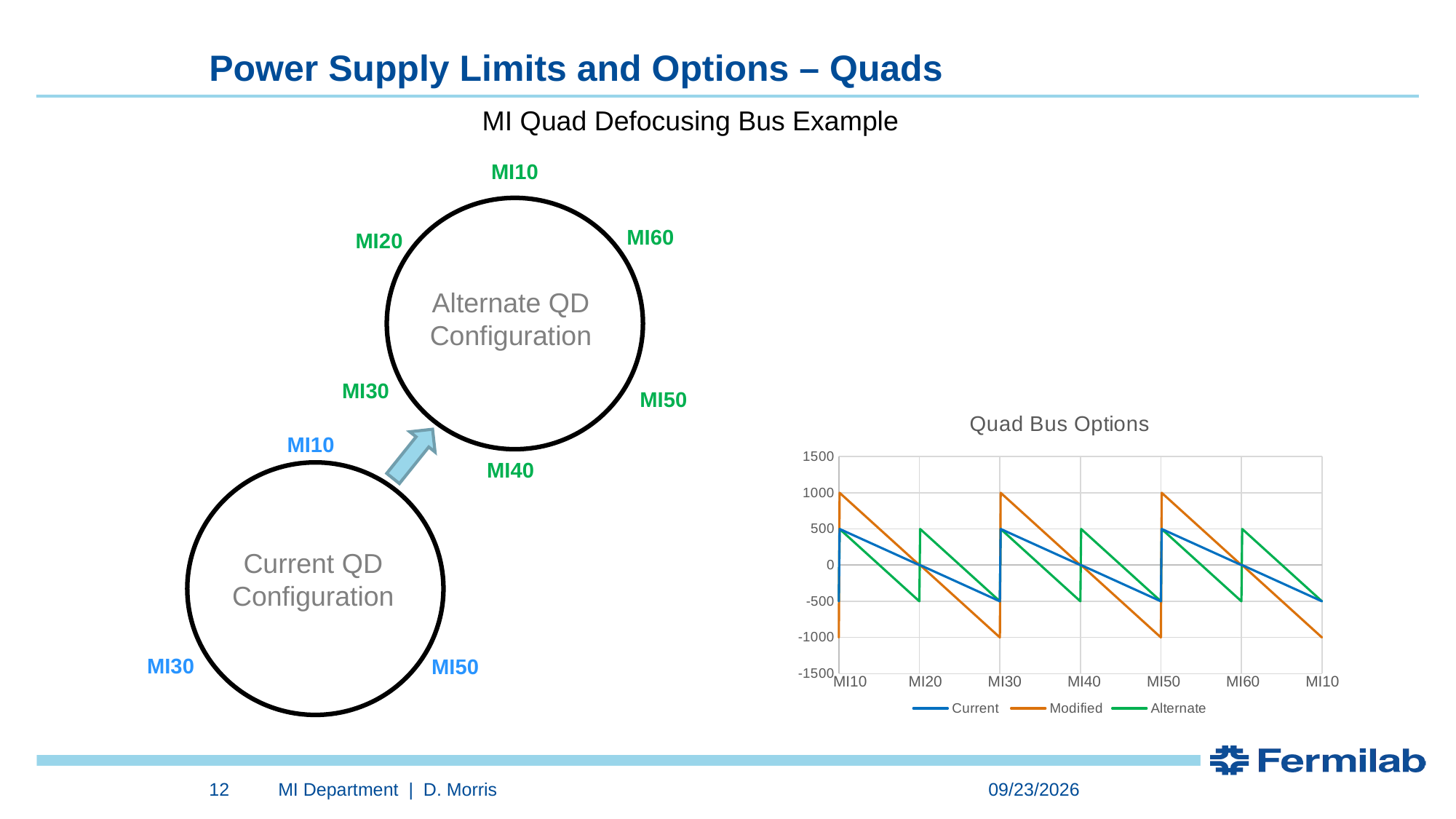
What are the series names in the legend of the "Quad Bus Options" chart? Current, Modified, Alternate How many series does the legend of the "Quad Bus Options" chart list? 3 In the "Quad Bus Options" chart, which series reaches the lowest value? Modified In the "Quad Bus Options" chart, which reaches a higher peak value, the Modified series or the Current series? Modified In the "Quad Bus Options" chart, which series reaches the highest value? Modified What kind of chart is the "Quad Bus Options" chart? line chart How many category labels are shown along the x axis of the "Quad Bus Options" chart? 7 In the "Quad Bus Options" chart, what is the lowest value reached by the Current series? -500 In the "Quad Bus Options" chart, what is the lowest value reached by the Modified series? -1000 In the "Quad Bus Options" chart, what is the highest value reached by the Modified series? 1000 In the "Quad Bus Options" chart, what is the highest value reached by the Alternate series? 500